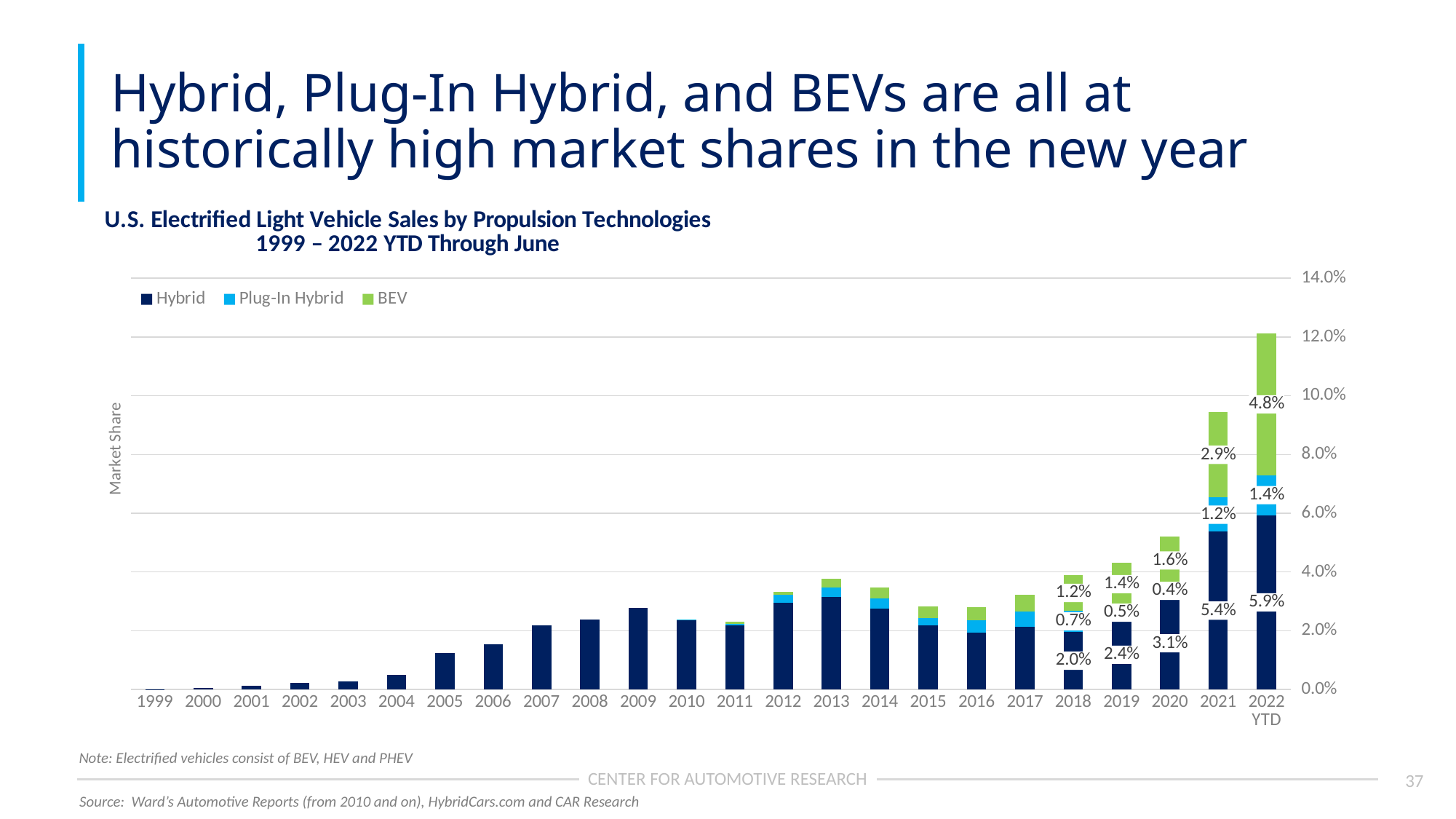
What is the Hybrid market share for 2022 YTD? 5.9% What kind of chart is shown on the slide? Stacked bar chart Which is larger in 2020, the Hybrid share or the BEV share? Hybrid What is the total electrified market share for 2021, summing the three labelled segments? 9.5% Which colour represents BEV in the chart? Green What is the difference between the BEV market share in 2022 YTD and in 2021? 1.9% What is the Hybrid market share for 2018? 2.0% Which year has the highest total electrified market share? 2022 YTD How many series does the legend list? 3 Is the total electrified market share for 2013 greater or less than 4.0%? less What is the BEV market share for 2021? 2.9% What is the Plug-In Hybrid market share for 2019? 0.5%